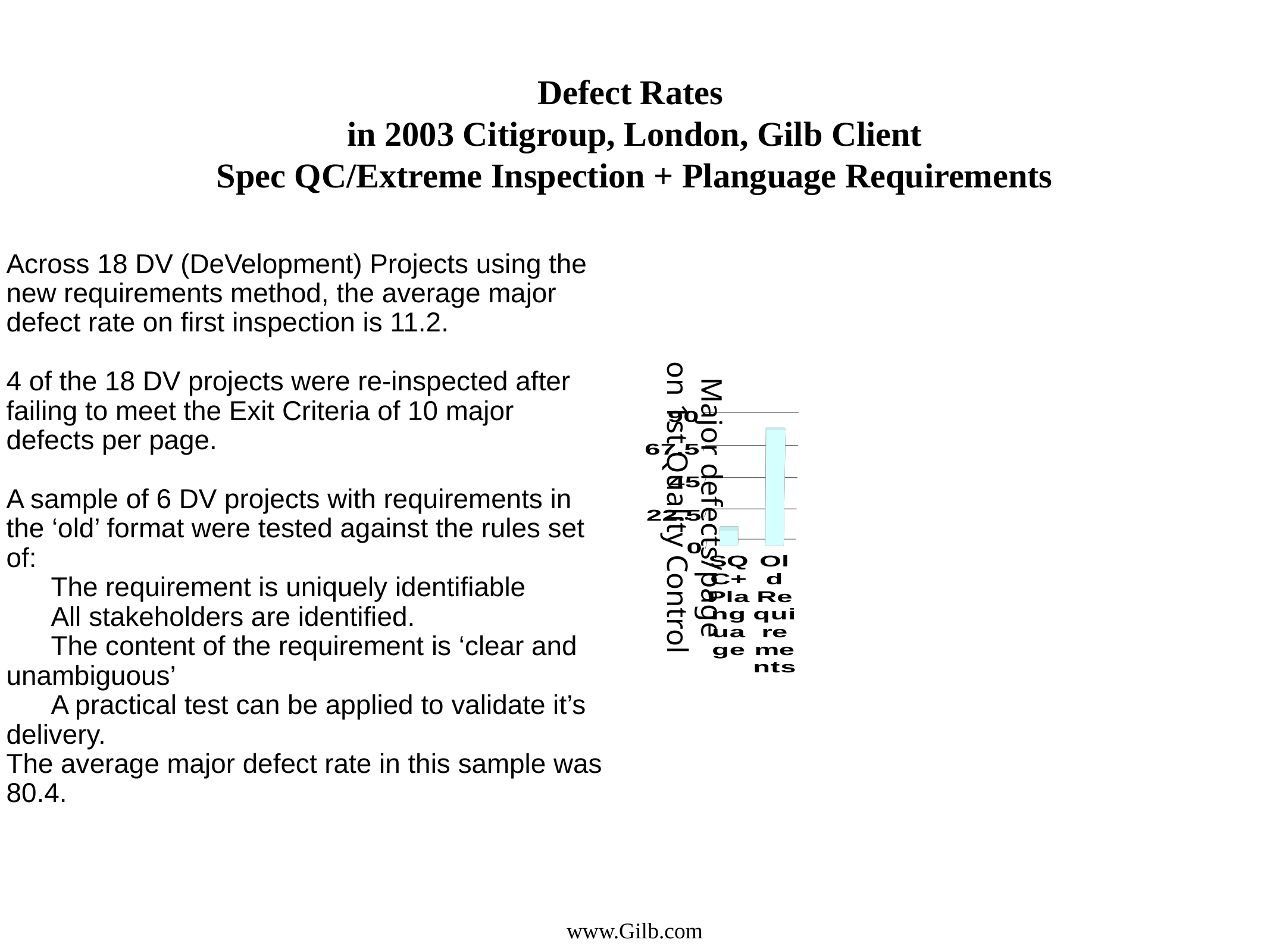
Which category has the highest major defects per page? Old Requirements Is the value for Old Requirements greater or less than 67.5? greater Is the value for Old Requirements greater or less than 45? greater Which is larger, the bar for SQC+Planguage or the bar for Old Requirements? Old Requirements Which category has the lowest major defects per page? SQC+Planguage How many bars does the chart show? 2 What is the highest tick value shown on the chart's vertical axis? 90 Is the value for SQC+Planguage greater or less than 22.5? less What kind of chart is shown on the slide? bar chart